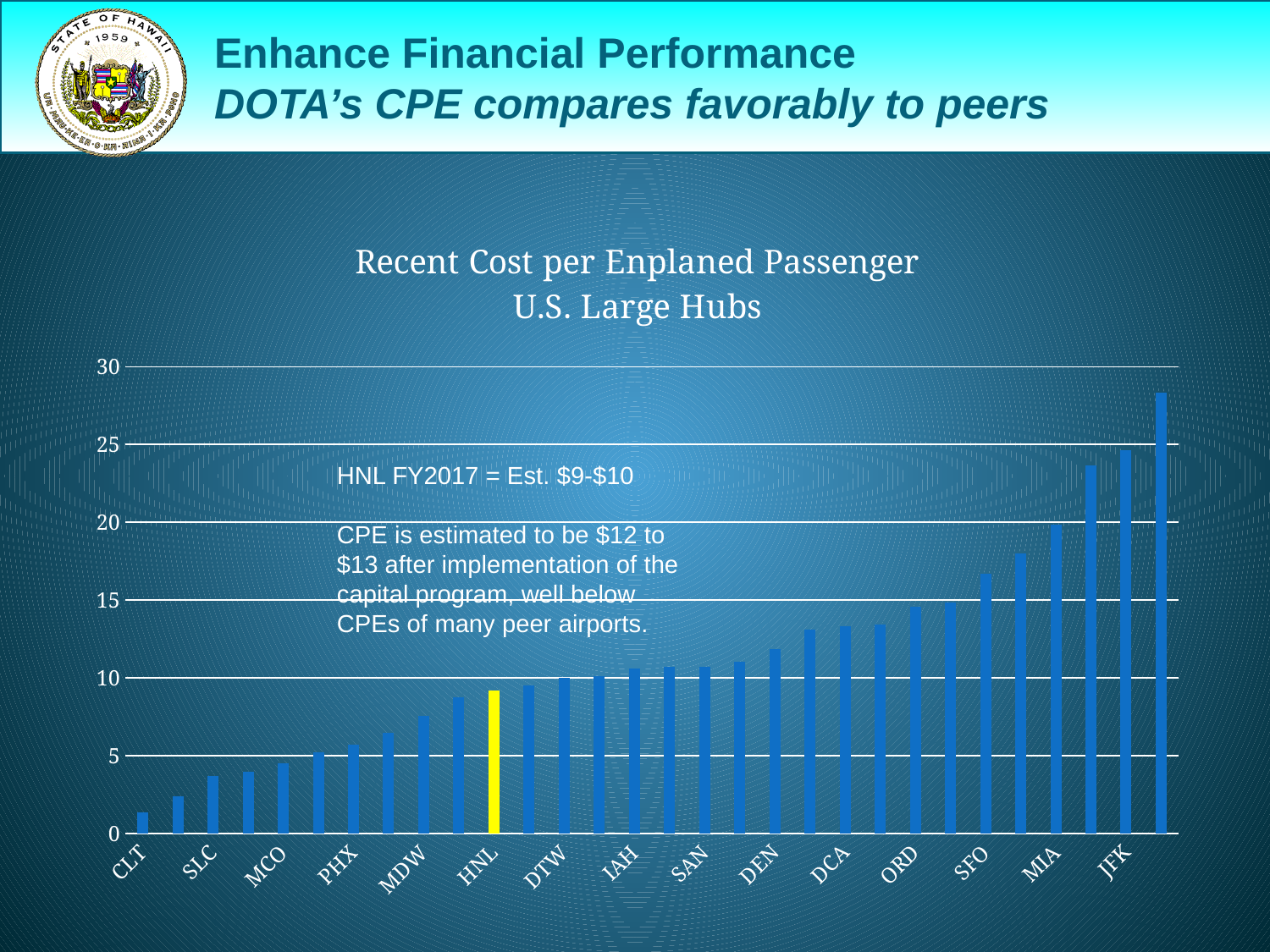
What kind of chart is shown on the slide? bar chart Is the value for HNL greater or less than 10? less What is the title of the chart? Recent Cost per Enplaned Passenger U.S. Large Hubs Is the value for SFO greater or less than 15? greater Which airport has the lowest cost per enplaned passenger in the chart? CLT Which bar is highlighted in yellow in the chart? HNL Which has a higher cost per enplaned passenger, MIA or SFO? MIA Is the value for SLC greater or less than 5? less Do the bar values rise or fall moving from left to right along the x axis? rise